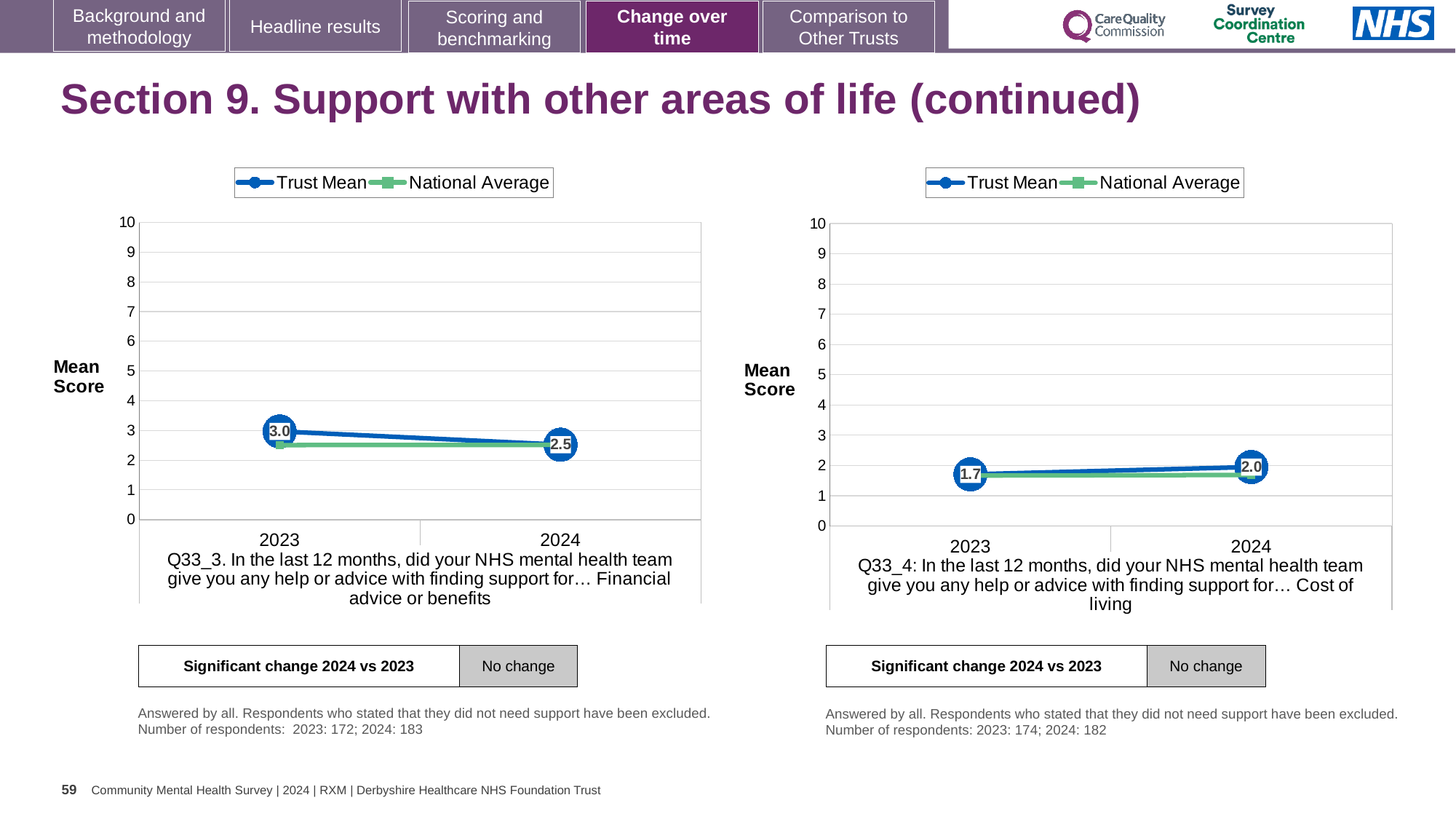
How many series does the legend of the right chart (Q33_4) list? 2 In the left chart (Q33_3, Financial advice or benefits), what is the Trust Mean for 2024? 2.5 In the right chart (Q33_4), which year has the higher Trust Mean, 2023 or 2024? 2024 In the left chart (Q33_3), by how much did the Trust Mean change from 2023 to 2024? 0.5 In the right chart (Q33_4, Cost of living), what is the Trust Mean for 2023? 1.7 In the right chart (Q33_4), what is the difference between the Trust Mean in 2024 and in 2023? 0.3 In the left chart (Q33_3), is the National Average for 2023 greater or less than 4? less In the right chart (Q33_4, Cost of living), what is the Trust Mean for 2024? 2.0 In the left chart (Q33_3, Financial advice or benefits), what is the Trust Mean for 2023? 3.0 What kind of chart is used on the left of the slide (Q33_3)? line chart In the right chart (Q33_4), does the Trust Mean rise or fall from 2023 to 2024? rise In the left chart (Q33_3), does the Trust Mean rise or fall from 2023 to 2024? fall